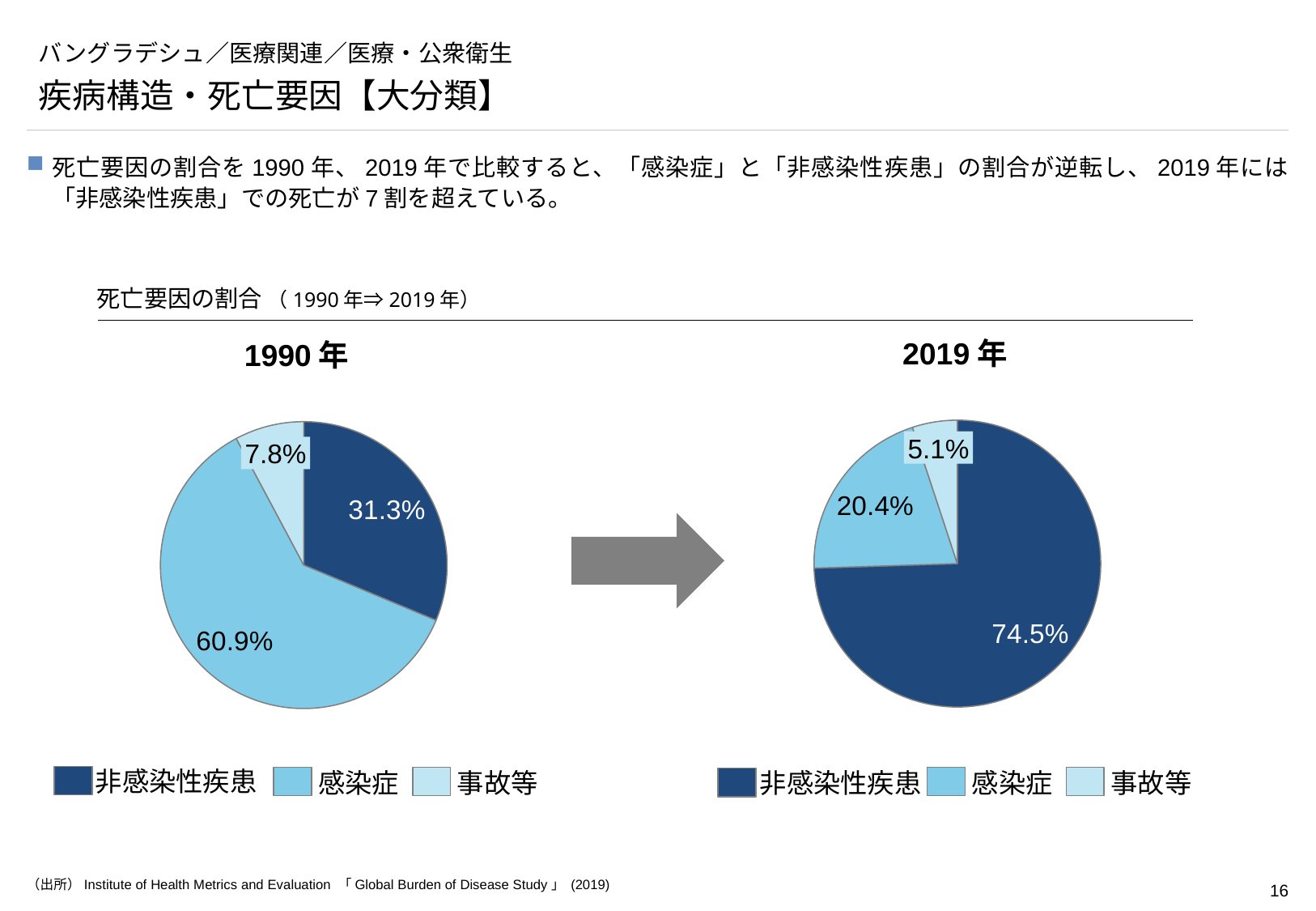
In the 2019年 pie chart, what is the share for 事故等? 5.1% How many categories does the 1990年 pie chart show? 3 Which is larger: the share of 事故等 in the 1990年 pie chart or in the 2019年 pie chart? 1990年 In the 2019年 pie chart, what is the difference between the shares of 非感染性疾患 and 感染症? 54.1% In the 1990年 pie chart, what is the share for 非感染性疾患? 31.3% In the 2019年 pie chart, what is the share for 非感染性疾患? 74.5% In the 2019年 pie chart, which category has the smallest share? 事故等 How many entries does the legend of the 2019年 chart list? 3 What kind of chart is used for the 2019年 data? Pie chart What is the title of the chart section containing the two pie charts? 死亡要因の割合（1990年⇒2019年） In the 1990年 pie chart, which category has the largest share? 感染症 In the 1990年 pie chart, what is the share for 感染症? 60.9%